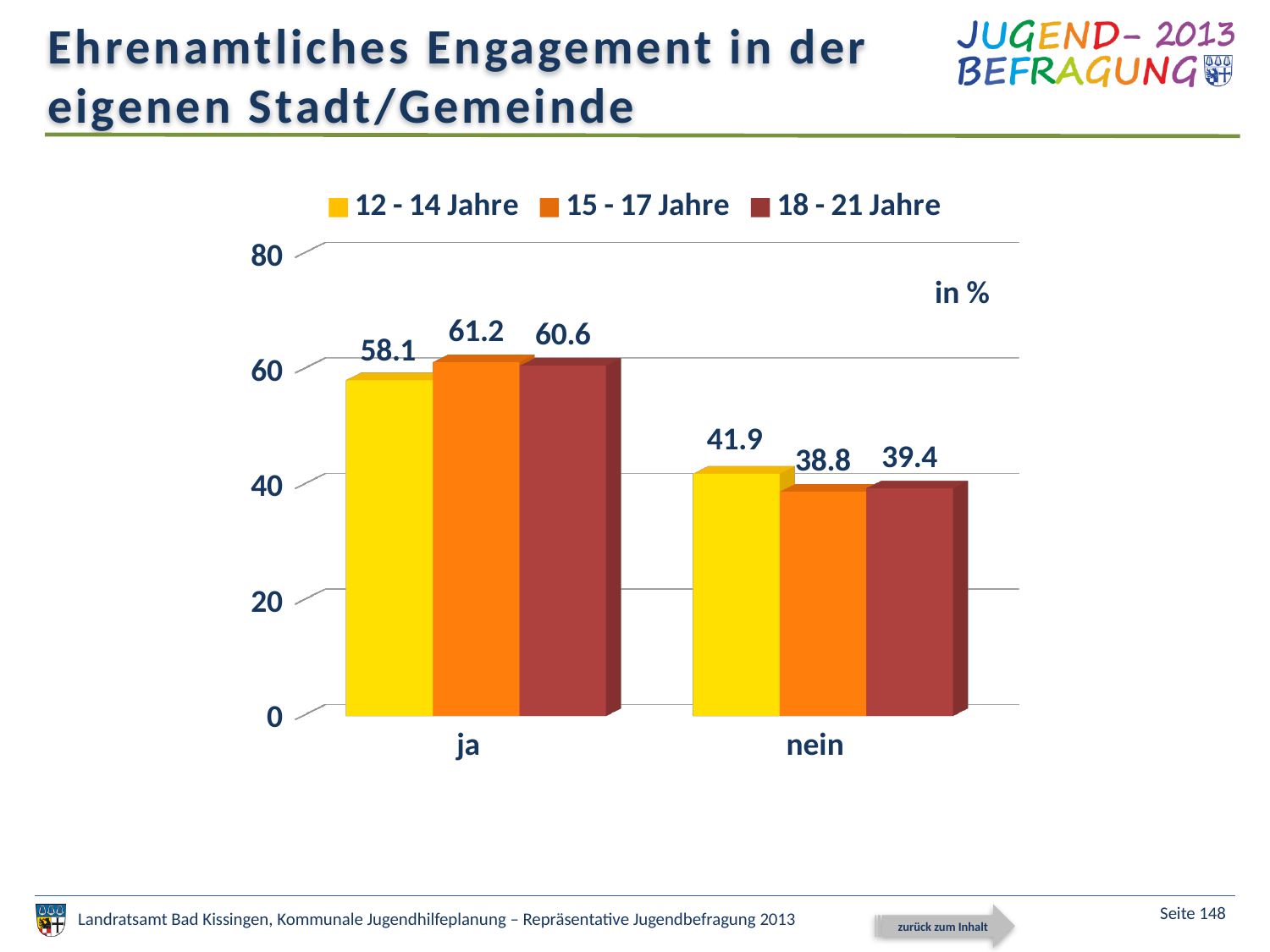
Which age group has the highest value in the ja category? 15 - 17 Jahre Which age group has the lowest value in the nein category? 15 - 17 Jahre What is the difference between the 12 - 14 Jahre values for ja and nein? 16.2 How many series does the legend list? 3 How many categories are shown on the x axis? 2 What is the value for the 15 - 17 Jahre series in the nein category? 38.8 What unit is indicated for the values in the chart? % What is the value for the 18 - 21 Jahre series in the ja category? 60.6 What kind of chart is shown on the slide? bar chart What is the value for the 12 - 14 Jahre series in the ja category? 58.1 Is the value for 12 - 14 Jahre in the nein category greater or less than 40? greater Which is larger: the 18 - 21 Jahre value for ja or the 18 - 21 Jahre value for nein? ja